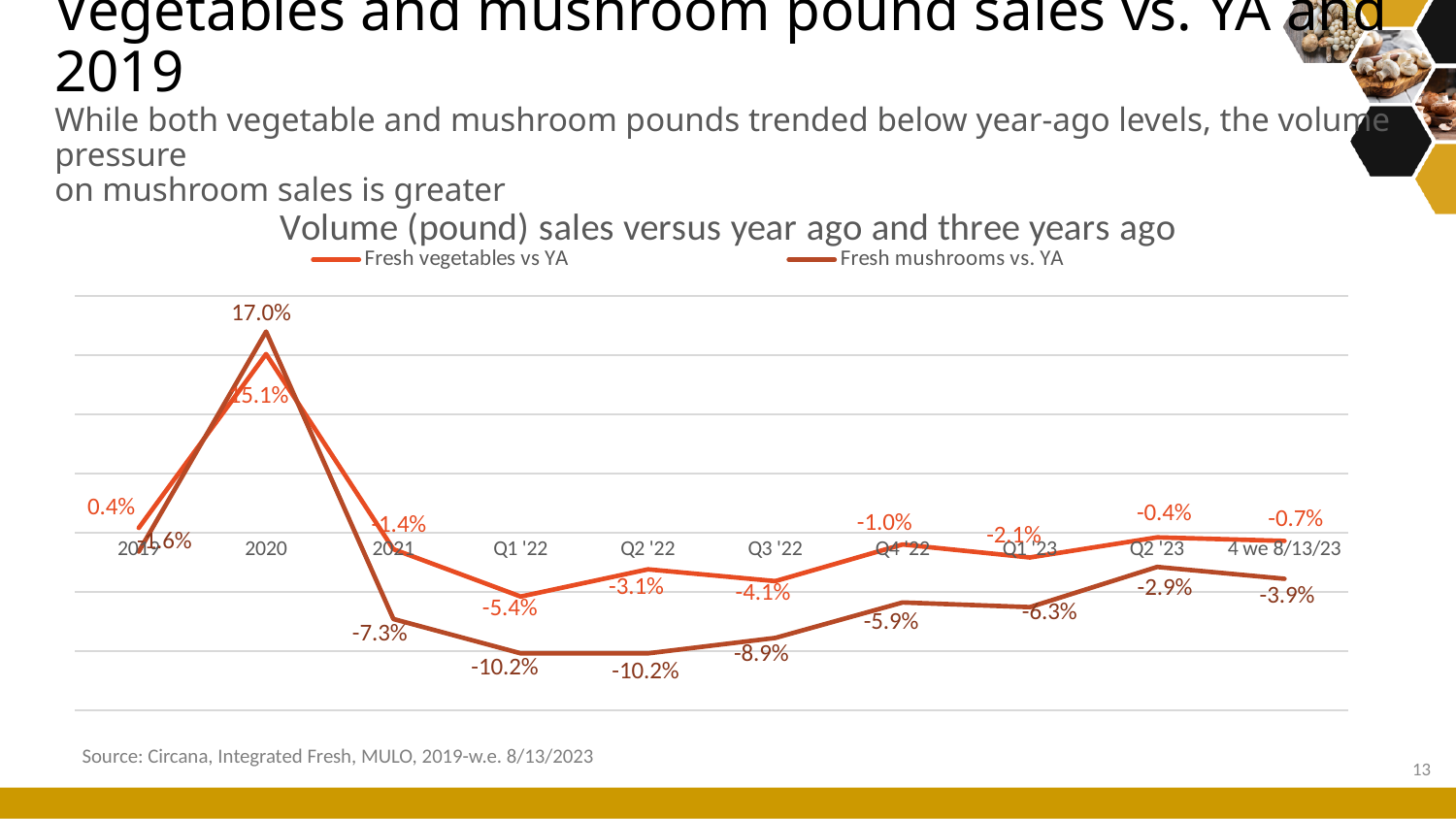
What is the value for Fresh mushrooms vs. YA in 2020? 17.0% How many time periods are plotted along the x axis of the chart? 10 In which period is the Fresh vegetables vs YA value lowest? Q1 '22 In which period is the Fresh mushrooms vs. YA value highest? 2020 What is the value for Fresh vegetables vs YA in Q1 '22? -5.4% What is the value for Fresh mushrooms vs. YA in the 4 we 8/13/23 period? -3.9% Does the Fresh mushrooms vs. YA line rise or fall from 2020 to Q1 '22? Fall In Q2 '23, which series has the higher value, Fresh vegetables vs YA or Fresh mushrooms vs. YA? Fresh vegetables vs YA What is the value for Fresh mushrooms vs. YA in Q3 '22? -8.9% What is the difference between the Fresh vegetables vs YA value (-1.0%) and the Fresh mushrooms vs. YA value (-5.9%) in Q4 '22? 4.9 percentage points How many series does the chart legend list? 2 What kind of chart is shown on the slide? Line chart